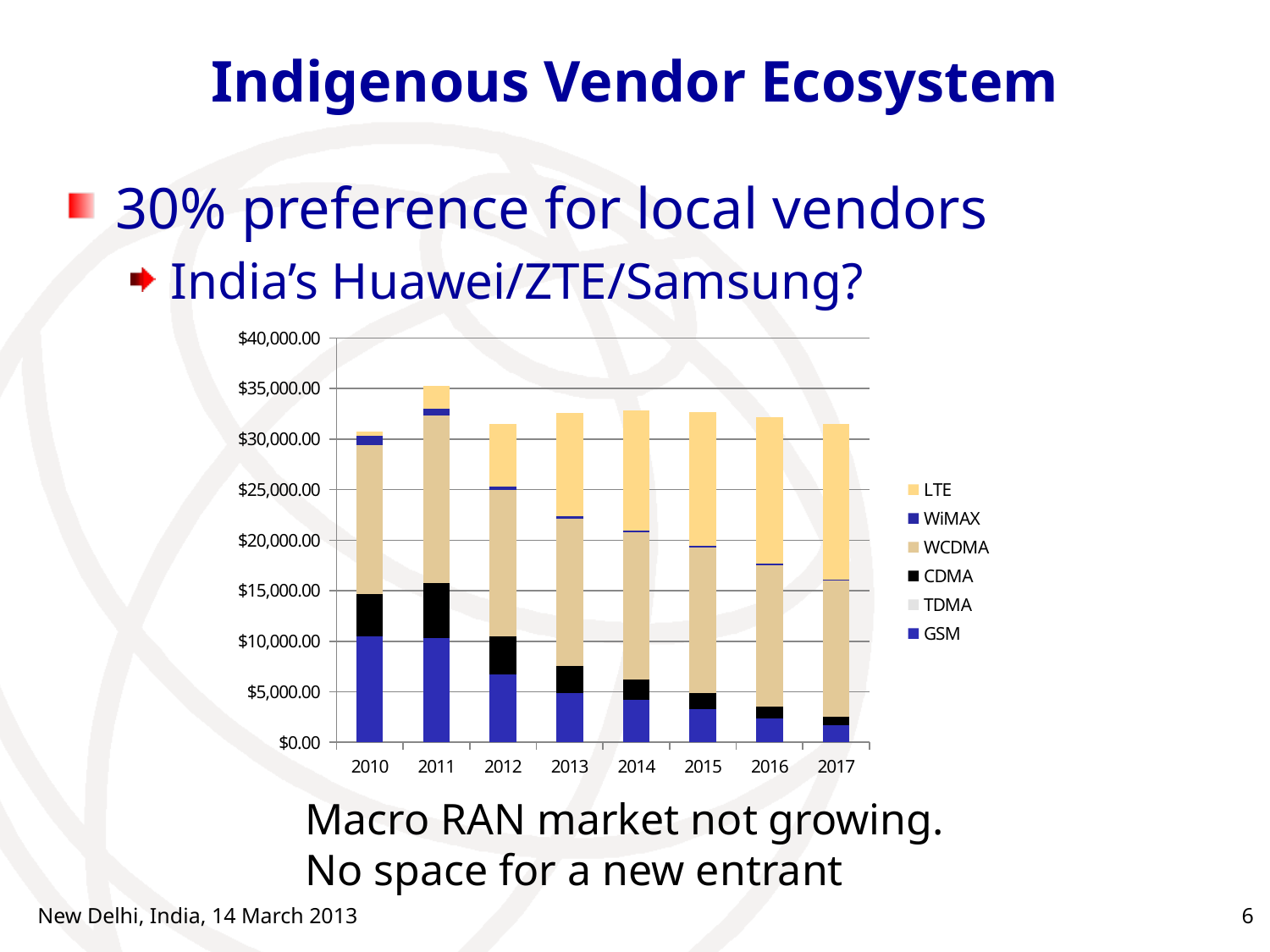
Is the total stacked value for 2017 greater or less than $30,000.00? greater Which is larger, the GSM segment in 2010 or the GSM segment in 2017? 2010 How many series does the chart's legend list? 6 Is the total stacked value for 2010 greater or less than $35,000.00? less Is the GSM value for 2017 greater or less than $5,000.00? less How many years are shown on the x axis of the chart? 8 Does the GSM segment rise or fall from 2010 to 2017? Fall Which is larger, the LTE segment in 2012 or the LTE segment in 2017? 2017 Which series is listed first (at the top) in the chart's legend? LTE What kind of chart is shown on the slide? Stacked bar chart Does the LTE segment rise or fall from 2010 to 2017? Rise Which year has the highest total stacked bar? 2011